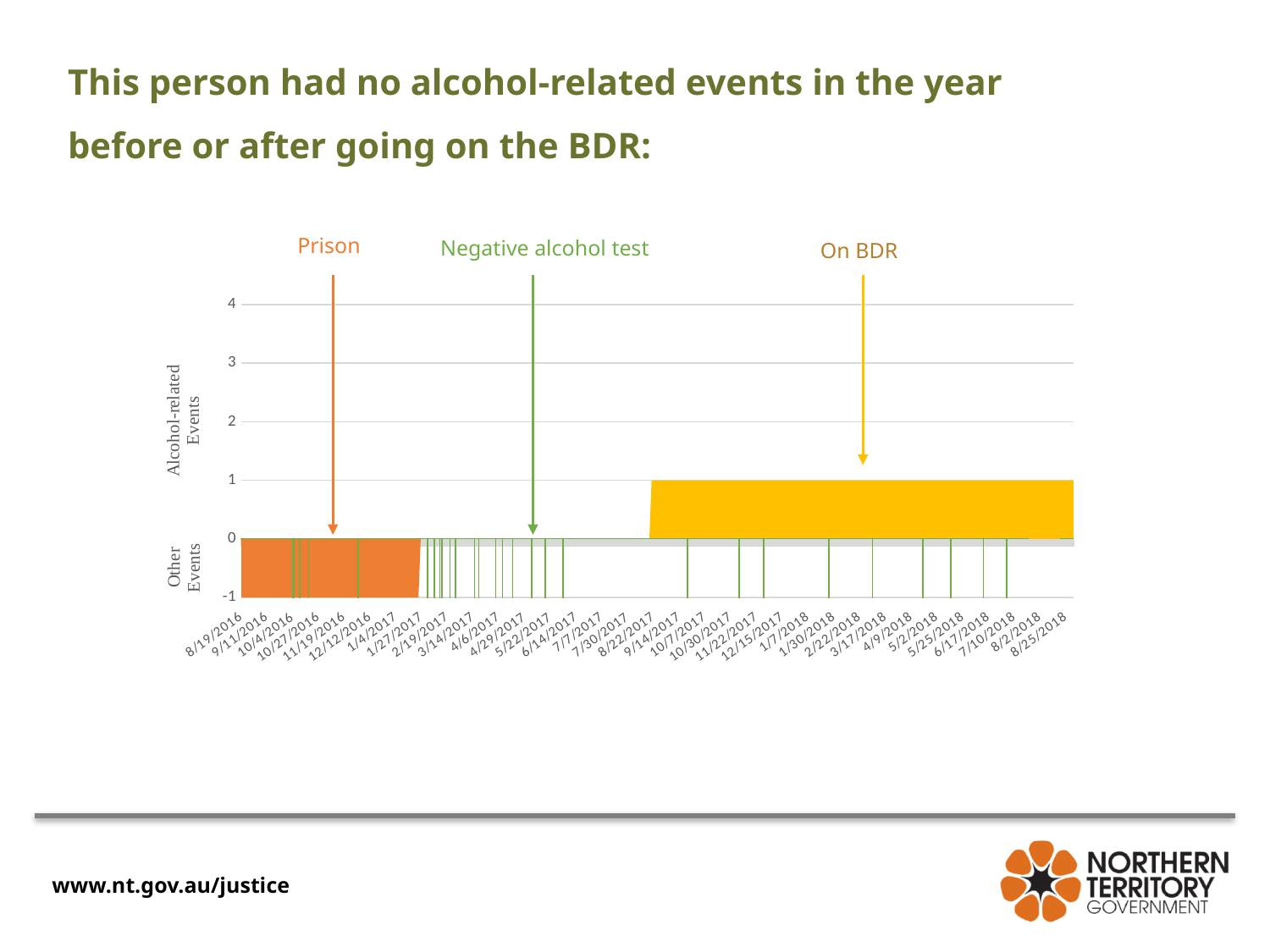
What is the lowest value shown on the y-axis? -1 What is the y-axis label for the values above zero? Alcohol-related Events What is the last date shown on the x-axis? 8/25/2018 How many labelled event types (with arrows) are annotated above the chart? 3 What is the first date shown on the x-axis? 8/19/2016 What is the highest value shown on the y-axis? 4 Is the height of the yellow 'On BDR' region greater or less than 2 on the y-axis? less What value on the y-axis does the yellow 'On BDR' shaded region reach? 1 What label is attached to the orange arrow above the chart? Prison